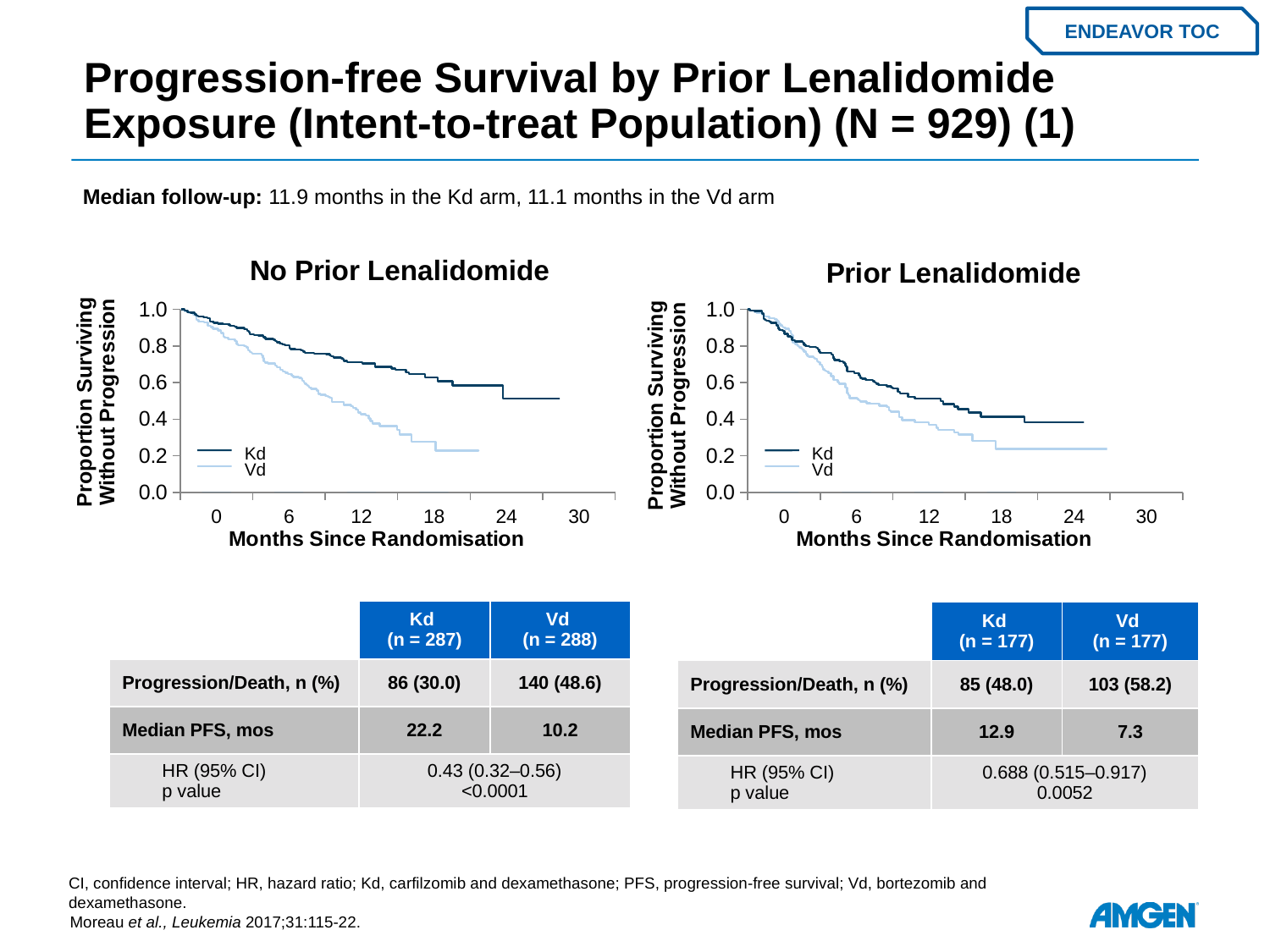
In the "No Prior Lenalidomide" chart, is the Vd proportion surviving without progression at 12 months greater or less than 0.6? less How many series does the legend of the "Prior Lenalidomide" chart list? 2 In the "No Prior Lenalidomide" chart, do the curves rise or fall as months since randomisation increase? Fall What kind of chart is the "No Prior Lenalidomide" chart? Line chart In the "No Prior Lenalidomide" chart, which two series are shown in the legend? Kd and Vd In the "No Prior Lenalidomide" chart, is the Vd proportion surviving without progression at 18 months greater or less than 0.4? less In the "Prior Lenalidomide" chart, does the Vd curve rise or fall along the x axis? Fall In the "No Prior Lenalidomide" chart, is the Kd proportion surviving without progression at 12 months greater or less than 0.6? greater In the "No Prior Lenalidomide" chart, which series has the higher proportion surviving without progression at 12 months, Kd or Vd? Kd What is the x-axis label of the "Prior Lenalidomide" chart? Months Since Randomisation